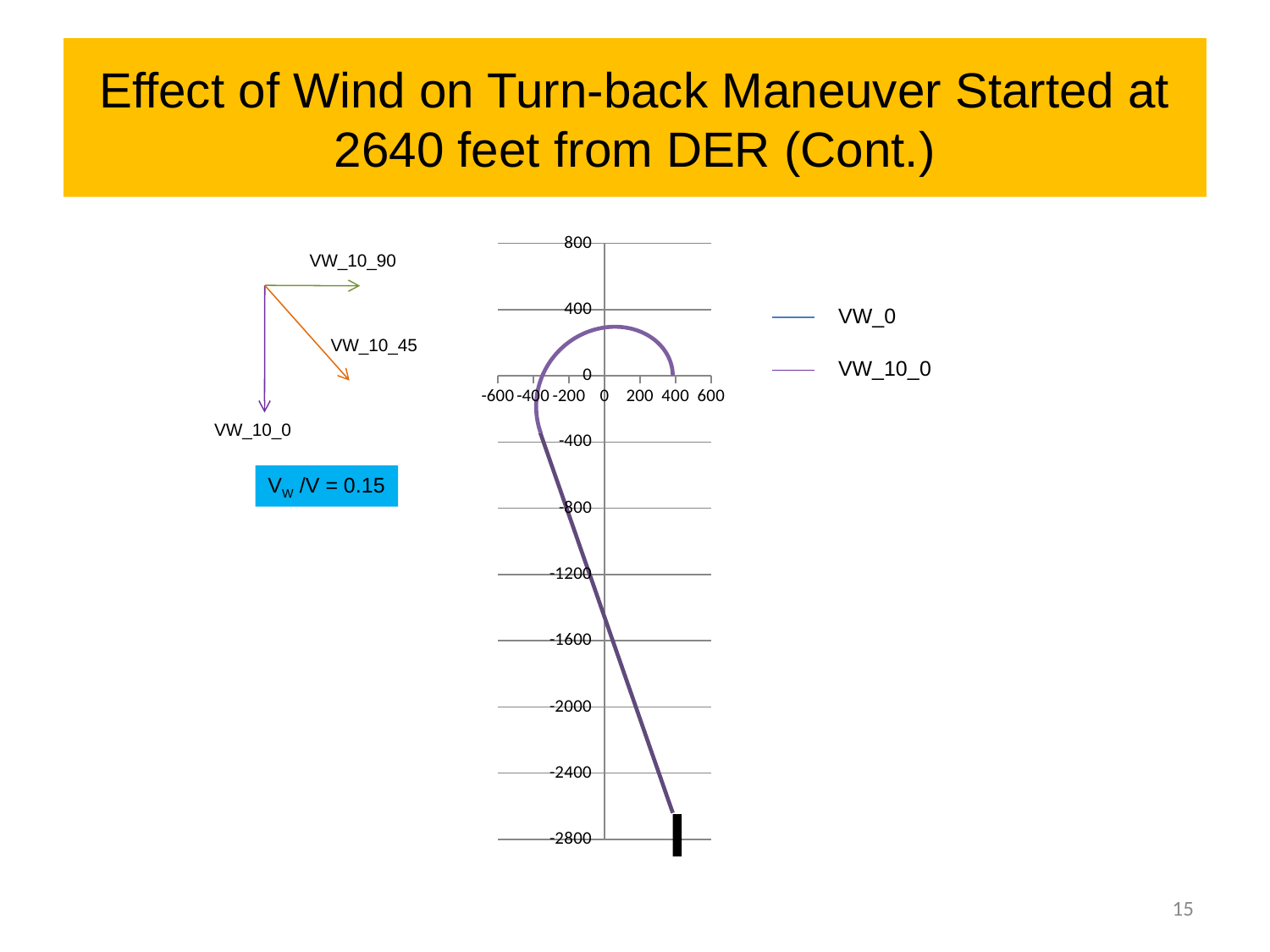
What kind of chart is shown on the slide? line chart Is the rightmost point of the plotted trajectory greater or less than 600 on the horizontal axis? less Is the lowest point of the plotted trajectory greater or less than -2400 on the vertical axis? less Is the highest point reached by the plotted trajectory greater or less than 400 on the vertical axis? less What is the highest value shown on the chart's vertical axis? 800 What are the names of the two series listed in the chart legend? VW_0 and VW_10_0 How many series does the chart legend list? 2